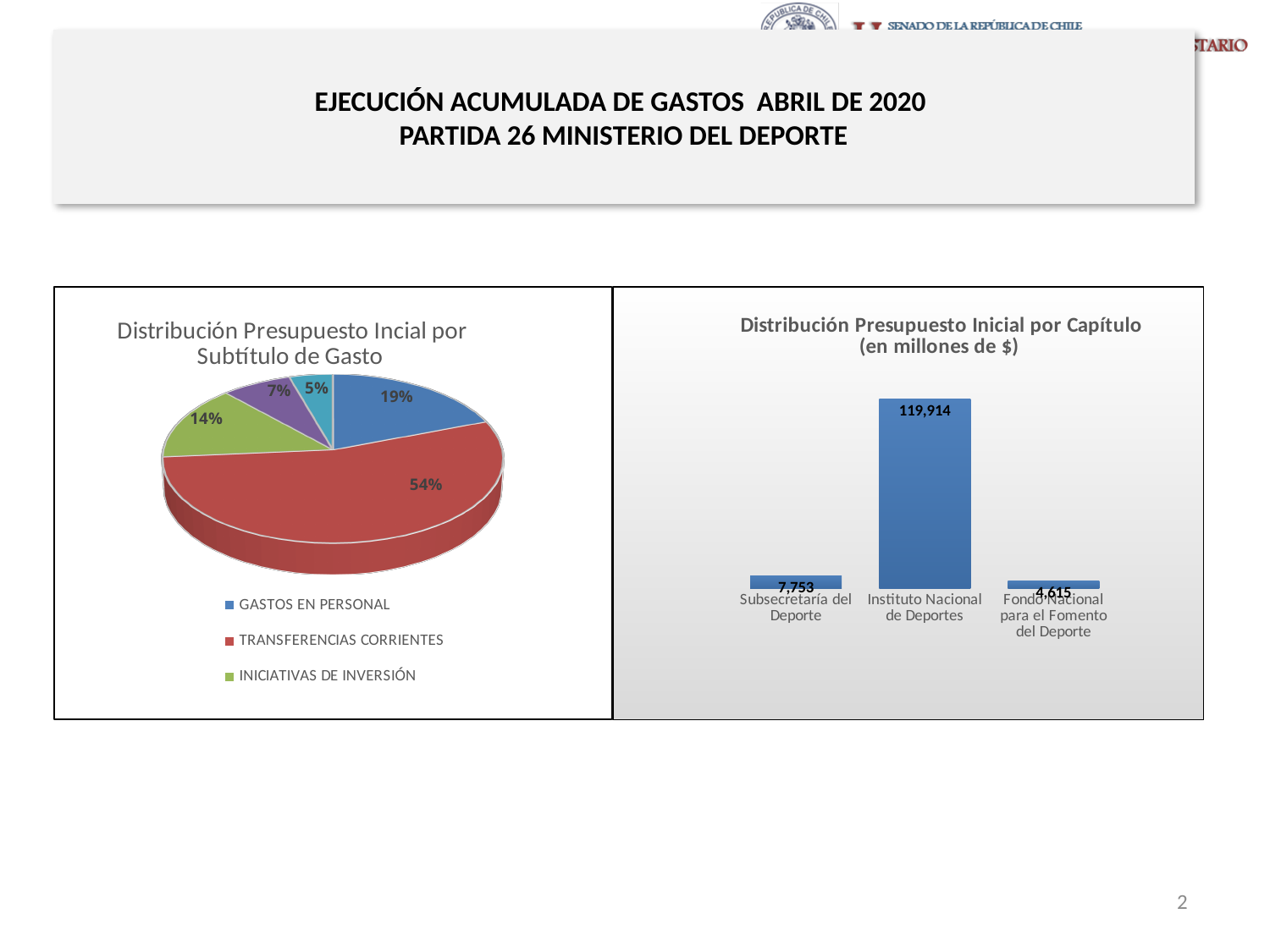
In the chart 'Distribución Presupuesto Inicial por Capítulo', what is the value for Subsecretaría del Deporte? 7,753 In the pie chart 'Distribución Presupuesto Incial por Subtítulo de Gasto', which legend entry has the largest slice? TRANSFERENCIAS CORRIENTES In the chart 'Distribución Presupuesto Inicial por Capítulo', what is the value for Fondo Nacional para el Fomento del Deporte? 4,615 In the chart 'Distribución Presupuesto Inicial por Capítulo', how many categories are shown? 3 In the chart 'Distribución Presupuesto Inicial por Capítulo', which category has the lowest value? Fondo Nacional para el Fomento del Deporte In the pie chart 'Distribución Presupuesto Incial por Subtítulo de Gasto', what share does GASTOS EN PERSONAL have? 19% How many entries does the legend of the pie chart 'Distribución Presupuesto Incial por Subtítulo de Gasto' list? 3 In the pie chart 'Distribución Presupuesto Incial por Subtítulo de Gasto', what share does TRANSFERENCIAS CORRIENTES have? 54% In the chart 'Distribución Presupuesto Inicial por Capítulo', what is the difference between the values for Instituto Nacional de Deportes and Subsecretaría del Deporte? 112,161 In the chart 'Distribución Presupuesto Inicial por Capítulo', what is the value for Instituto Nacional de Deportes? 119,914 In the chart 'Distribución Presupuesto Inicial por Capítulo', which category has the highest value? Instituto Nacional de Deportes What kind of chart is 'Distribución Presupuesto Inicial por Capítulo'? Bar chart